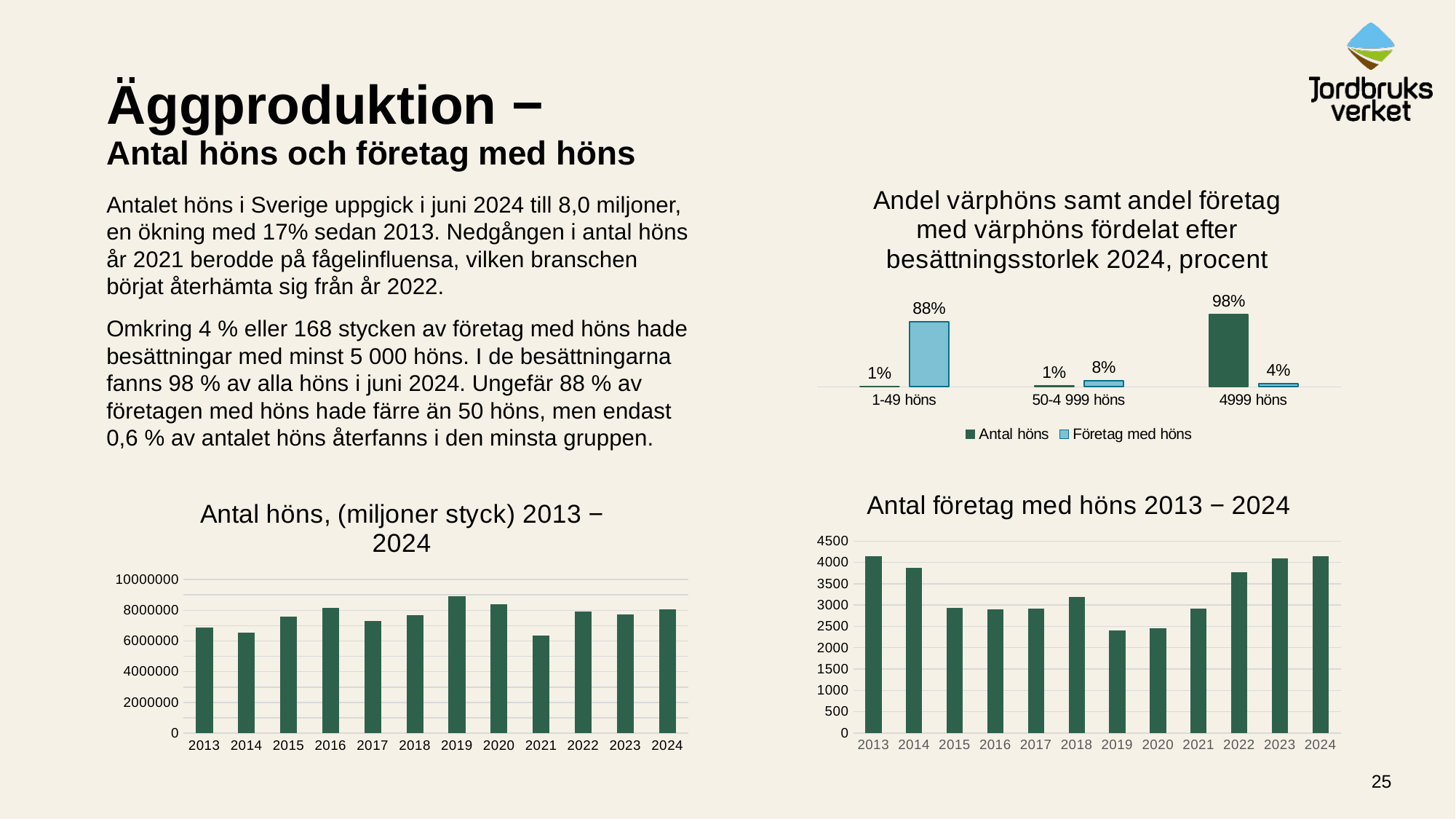
In the chart 'Antal företag med höns 2013 − 2024', is the value for 2019 greater or less than 2500? less In the chart 'Antal höns, (miljoner styck) 2013 − 2024', which year has the lowest value? 2021 In the chart 'Antal höns, (miljoner styck) 2013 − 2024', which year has the highest value? 2019 In the chart 'Andel värphöns samt andel företag med värphöns fördelat efter besättningsstorlek 2024, procent', what is the value of 'Företag med höns' for '50-4 999 höns'? 8% How many series does the legend of the chart 'Andel värphöns samt andel företag med värphöns fördelat efter besättningsstorlek 2024, procent' list? 2 In the chart 'Andel värphöns samt andel företag med värphöns fördelat efter besättningsstorlek 2024, procent', what is the value of 'Antal höns' for the rightmost category? 98% How many years are shown on the x axis of the chart 'Antal höns, (miljoner styck) 2013 − 2024'? 12 What kind of chart is 'Antal företag med höns 2013 − 2024'? bar chart In the chart 'Antal företag med höns 2013 − 2024', which year has the larger value, 2015 or 2022? 2022 In the chart 'Andel värphöns samt andel företag med värphöns fördelat efter besättningsstorlek 2024, procent', what is the value of 'Företag med höns' for the category '1-49 höns'? 88% In the chart 'Andel värphöns samt andel företag med värphöns fördelat efter besättningsstorlek 2024, procent', what is the difference between 'Företag med höns' and 'Antal höns' for '1-49 höns'? 87 percentage points In the chart 'Antal höns, (miljoner styck) 2013 − 2024', is the value for 2019 greater or less than 8000000? greater